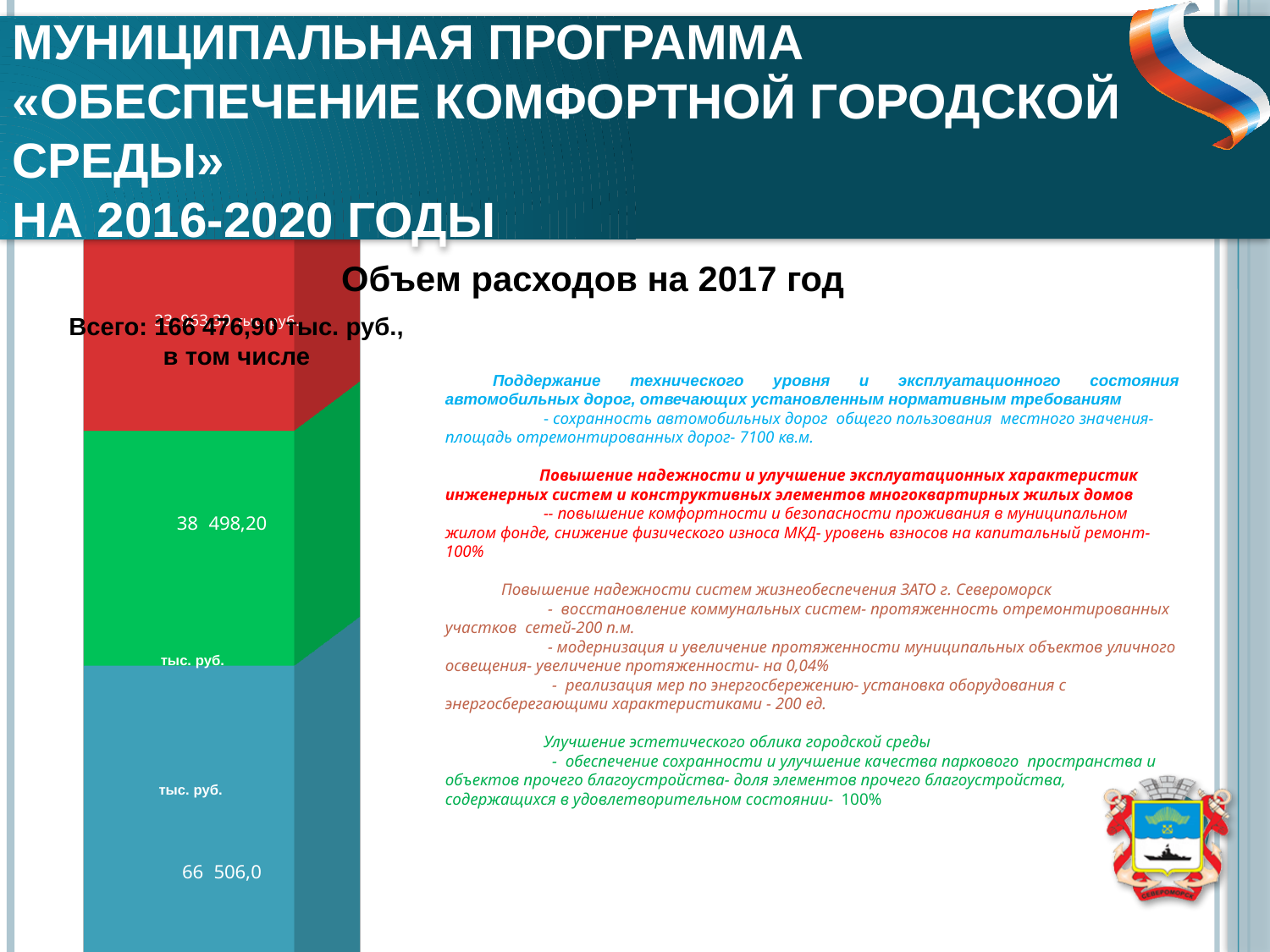
What total amount (Всего) is stated next to the chart? 166 476,90 тыс. руб. How many segments does the stacked bar have? 3 What is the difference between the blue segment (66 506,0) and the green segment (38 498,20)? 28 007,80 Which is larger, the blue (bottom) segment or the green (middle) segment? Blue (bottom) segment What is the title shown above the chart area? Объем расходов на 2017 год What is the value printed on the blue (bottom) segment of the bar? 66 506,0 What kind of chart is shown on the left of the slide? Stacked bar chart What is the value printed on the green (middle) segment of the bar? 38 498,20 Which segment of the stacked bar is the largest? Blue (bottom) segment Which segment of the stacked bar is the smallest? Red (top) segment